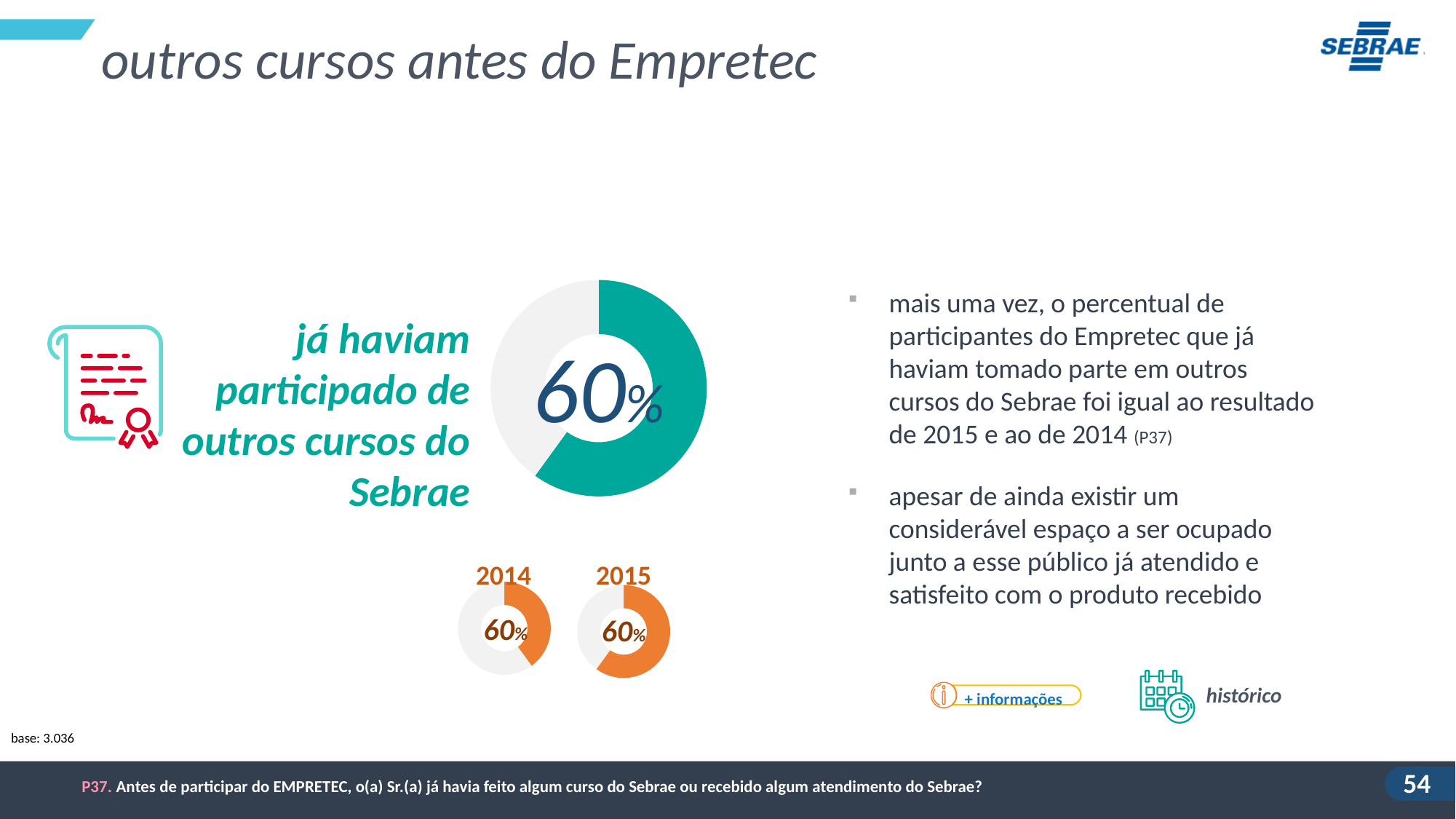
Looking at the small donut charts, does the value rise, fall or stay the same from 2014 to 2015? stays the same How many small donut charts with year labels are shown on the slide? 2 In the large donut chart, what share of the circle is not filled by the highlighted 60% segment? 40% In the small donut chart labelled 2015, what value is shown? 60% What kind of chart is the large chart in the centre of the slide? pie chart (donut) What colour is the filled segment of the large donut chart? teal (green) In the large donut chart, what percentage of participants had already taken part in other Sebrae courses? 60% What colour are the filled segments of the 2014 and 2015 donut charts? orange What is the difference between the 2015 value and the 2014 value in the small donut charts? 0 percentage points In the small donut chart labelled 2014, what value is shown? 60% Is the value shown in the large donut chart greater or less than 50%? greater Comparing the 2014 and 2015 donut charts, is the 2014 value larger, smaller or equal to the 2015 value? equal